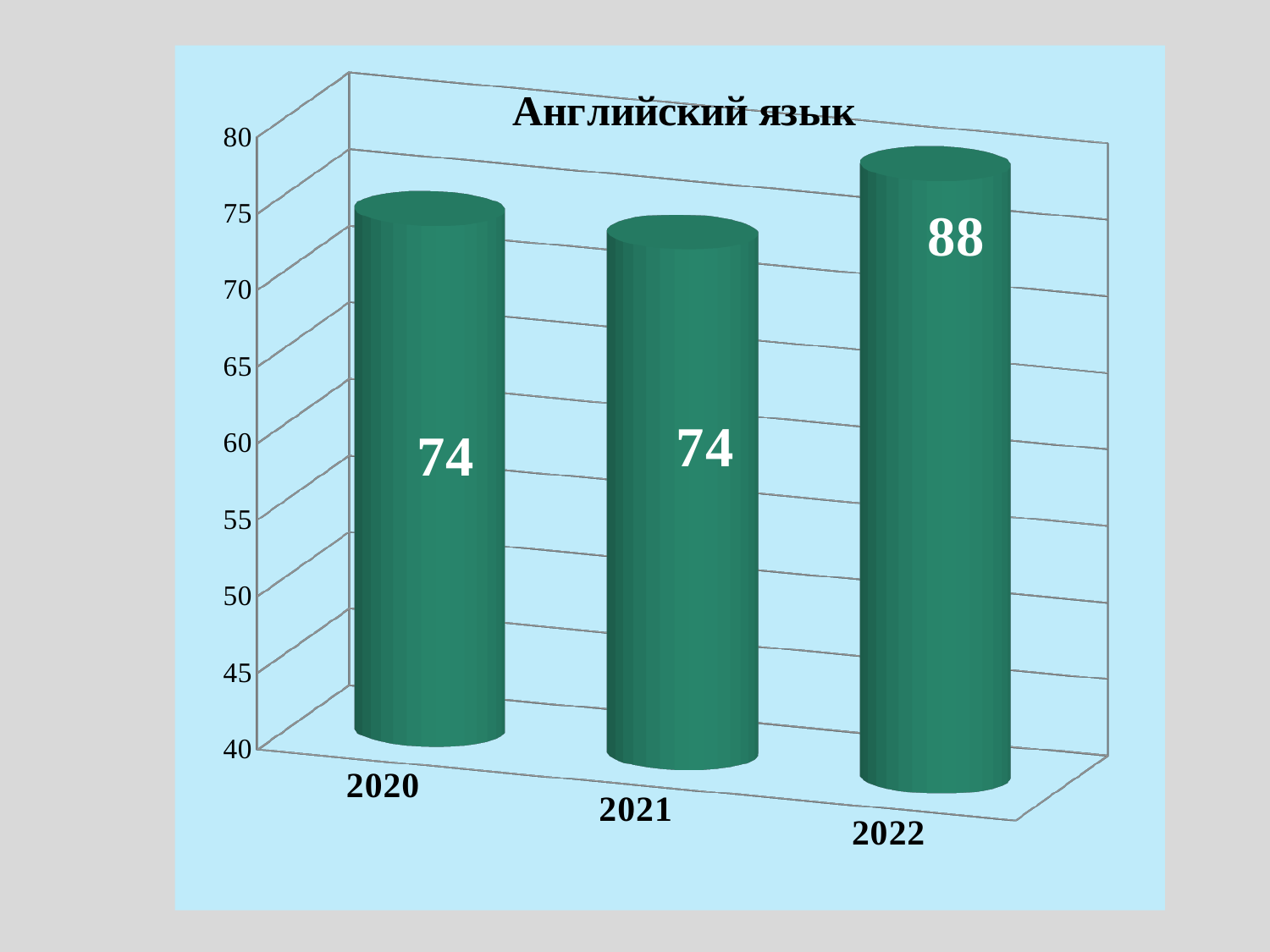
Which is larger, the value for 2022 or the value for 2020? 2022 Is the value for 2020 greater or less than 75? less What is the difference between the values for 2022 and 2021? 14 What is the value for 2022? 88 Which year has the highest value? 2022 Do the values rise or fall from 2021 to 2022? rise What is the title of the chart? Английский язык What kind of chart is shown on the slide? bar chart What is the value for 2020? 74 What is the value for 2021? 74 How many years are shown on the chart? 3 Is the value for 2022 greater or less than 80? greater